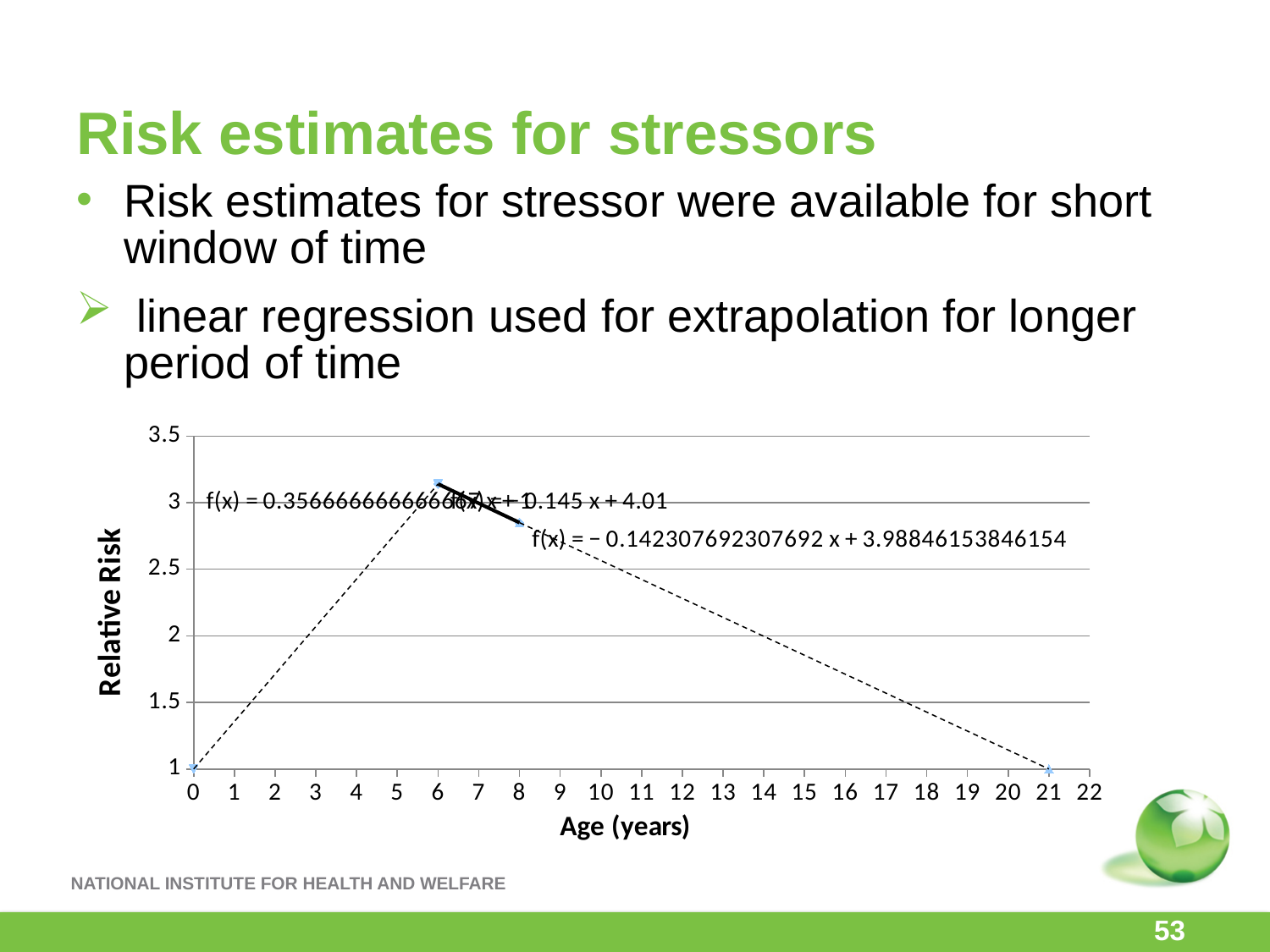
What is the relative risk plotted at age 21? 1 Which age has the highest plotted relative risk? 6 What is the title of the y axis of the chart? Relative Risk What kind of chart is shown on the slide? scatter chart Does the relative risk rise or fall between age 8 and age 21? fall Which is larger, the relative risk at age 6 or at age 8? age 6 Is the relative risk at age 8 greater or less than 2.5? greater Is the relative risk at age 6 greater or less than 3? greater Is the relative risk at age 8 greater or less than 3? less Does the relative risk rise or fall between age 0 and age 6? rise What is the relative risk plotted at age 0? 1 What is the title of the x axis of the chart? Age (years)